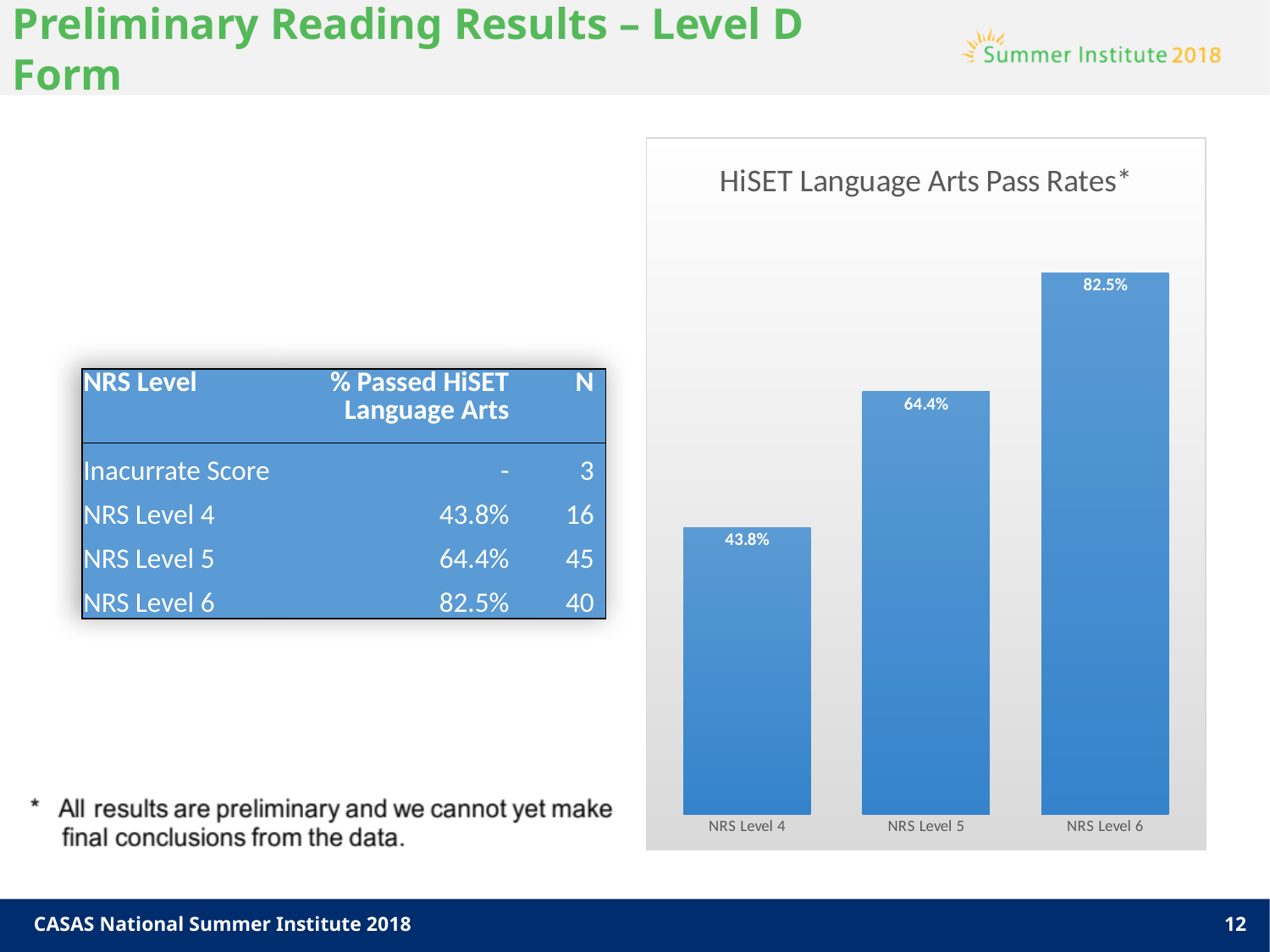
What is the HiSET Language Arts pass rate for NRS Level 5? 64.4% What is the difference in pass rate between NRS Level 5 and NRS Level 4? 20.6% Which NRS level has the lowest HiSET Language Arts pass rate? NRS Level 4 Do the pass rates rise or fall from NRS Level 4 to NRS Level 6? Rise What type of chart is shown on the slide? Bar chart What is the difference in pass rate between NRS Level 6 and NRS Level 4? 38.7% How many NRS levels are shown in the chart? 3 What is the HiSET Language Arts pass rate for NRS Level 4? 43.8% What is the HiSET Language Arts pass rate for NRS Level 6? 82.5% Which has a higher pass rate, NRS Level 5 or NRS Level 6? NRS Level 6 What is the title of the chart? HiSET Language Arts Pass Rates* Which NRS level has the highest HiSET Language Arts pass rate? NRS Level 6